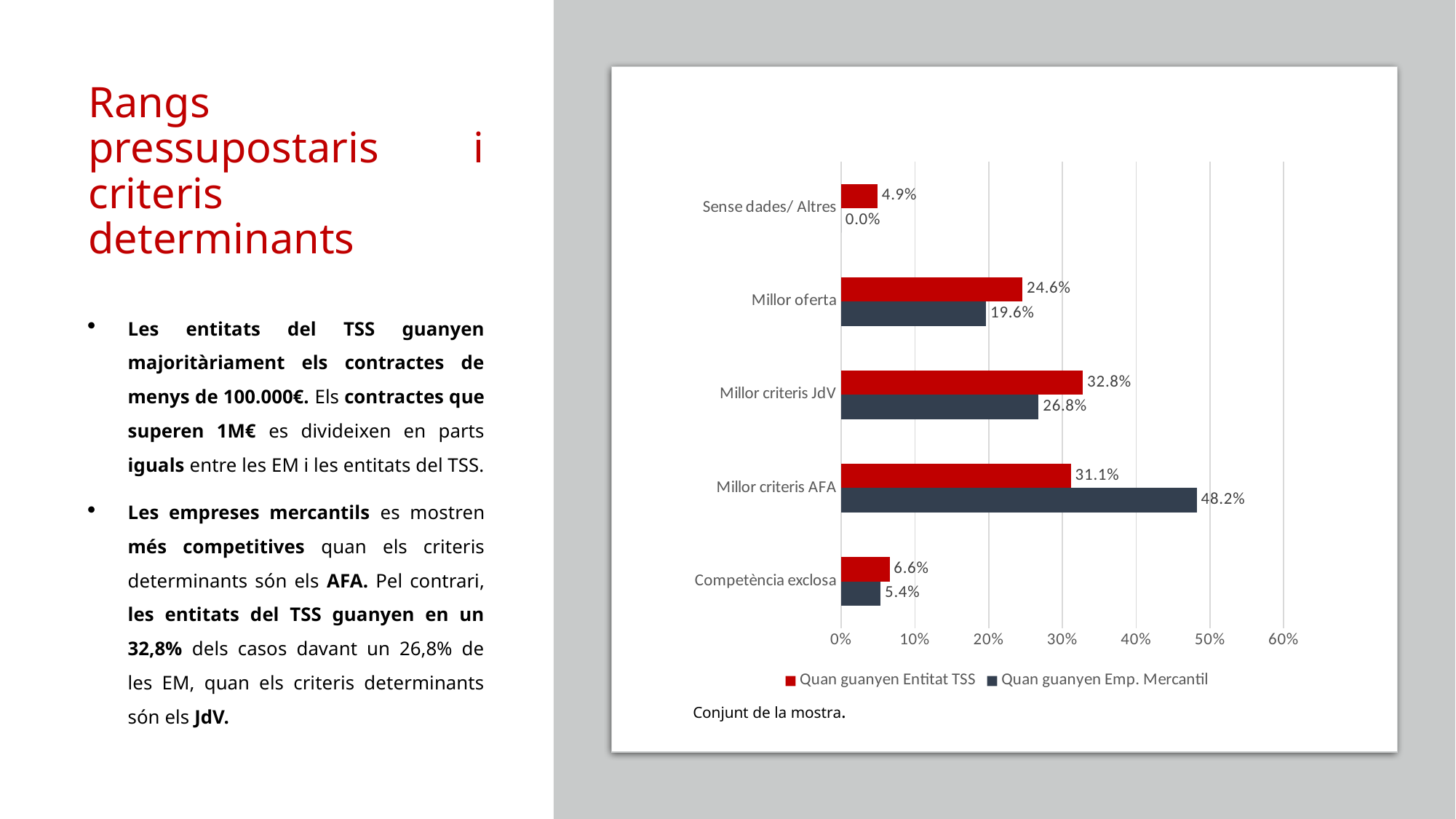
For Millor oferta, which series has the larger value: Quan guanyen Entitat TSS or Quan guanyen Emp. Mercantil? Quan guanyen Entitat TSS What kind of chart is shown on the slide? Bar chart What is the value for Millor criteris JdV in the Quan guanyen Entitat TSS series? 32.8% What is the difference between the Quan guanyen Emp. Mercantil and Quan guanyen Entitat TSS values for Millor criteris AFA? 17.1% Is the value for Millor criteris AFA in the Quan guanyen Emp. Mercantil series greater or less than 40%? greater How many categories are shown on the chart? 5 How many series does the legend list? 2 What is the value for Millor criteris AFA in the Quan guanyen Emp. Mercantil series? 48.2% Which category has the lowest value in the Quan guanyen Entitat TSS series? Sense dades/ Altres Which category has the highest value in the Quan guanyen Emp. Mercantil series? Millor criteris AFA What is the value for Sense dades/ Altres in the Quan guanyen Emp. Mercantil series? 0.0% What colour represents the Quan guanyen Entitat TSS series? Red